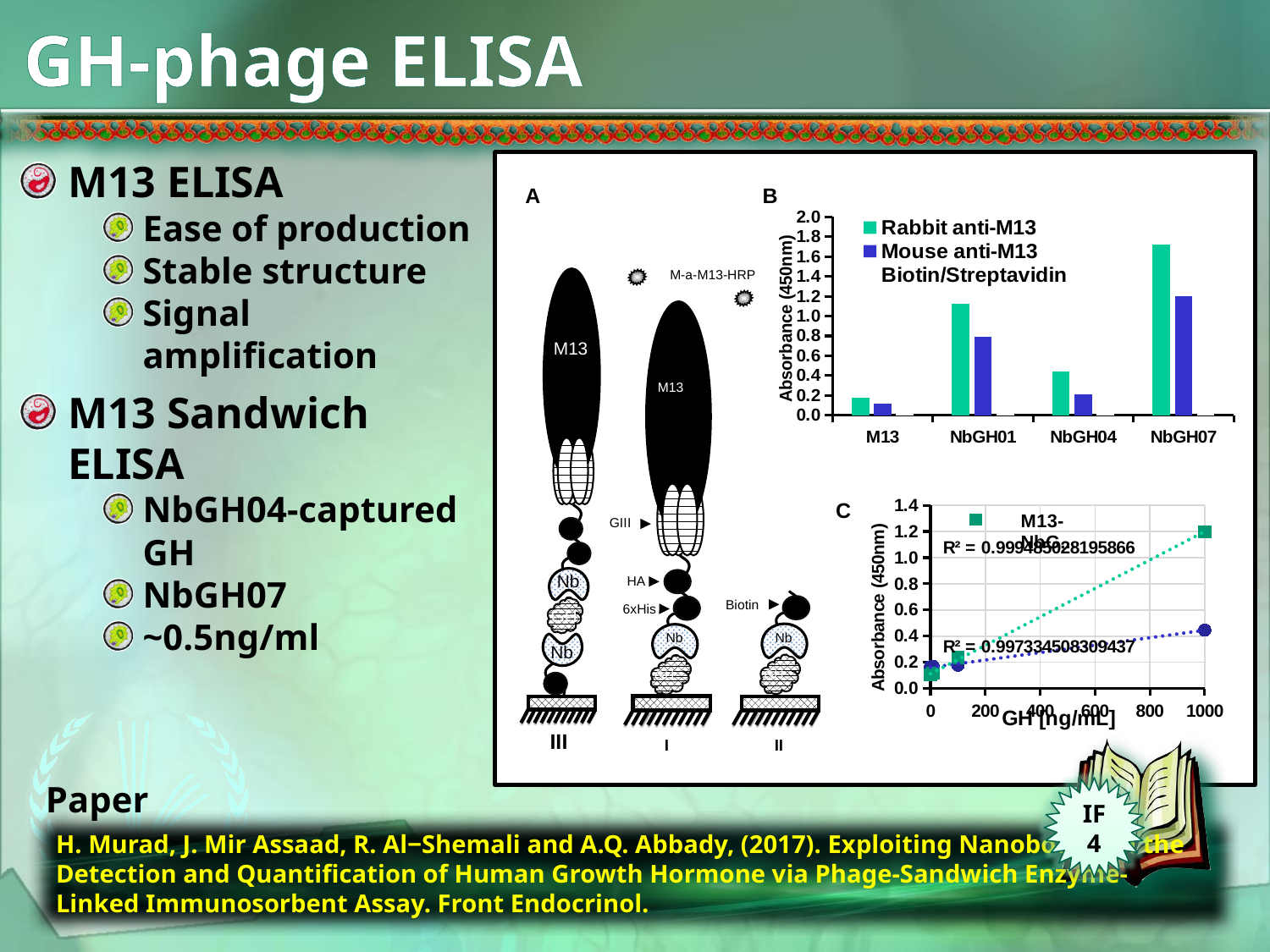
In chart B, what is the y-axis title? Absorbance (450nm) In chart B, is the Rabbit anti-M13 value for NbGH07 greater or less than 1.4? greater In chart B, for NbGH07, which series has the larger value: Rabbit anti-M13 or Mouse anti-M13? Rabbit anti-M13 In chart B, is the Mouse anti-M13 value for NbGH01 greater or less than 1.0? less In chart C, what R² value is printed for the upper (green) trend line? 0.999485028195866 In chart B, how many series does the legend list? 3 In chart B, which category has the lowest Rabbit anti-M13 absorbance? M13 In chart B, is the Rabbit anti-M13 value larger for NbGH01 or NbGH04? NbGH01 In chart B, how many categories are shown on the x axis? 4 In chart B, which category has the highest Rabbit anti-M13 absorbance? NbGH07 In chart C, what is the x-axis title? GH [ng/mL] What kind of chart is chart B? bar chart